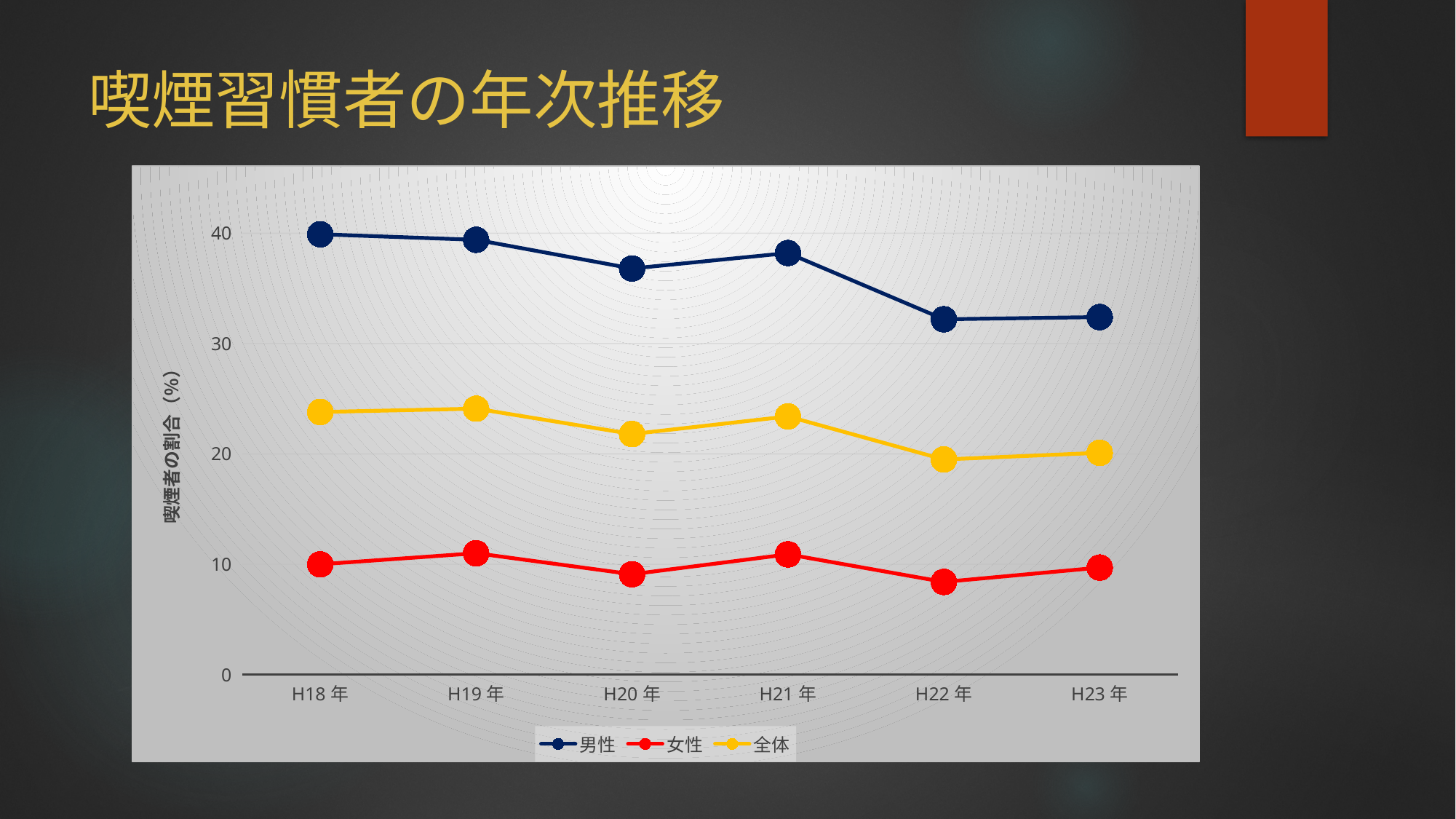
In which year is the value for 女性 lowest? H22 年 Overall, does the 男性 line rise or fall from H18 年 to H23 年? fall Is the value for 全体 in H18 年 greater or less than 20? greater How many series does the legend list? 3 For 男性, which is larger: the value in H18 年 or the value in H22 年? H18 年 How many years are plotted along the x axis? 6 Is the value for 女性 in H22 年 greater or less than 10? less Is the value for 男性 in H22 年 greater or less than 40? less What is the title of the slide? 喫煙習慣者の年次推移 Which series is shown in red in the legend? 女性 What kind of chart is shown on the slide? line chart